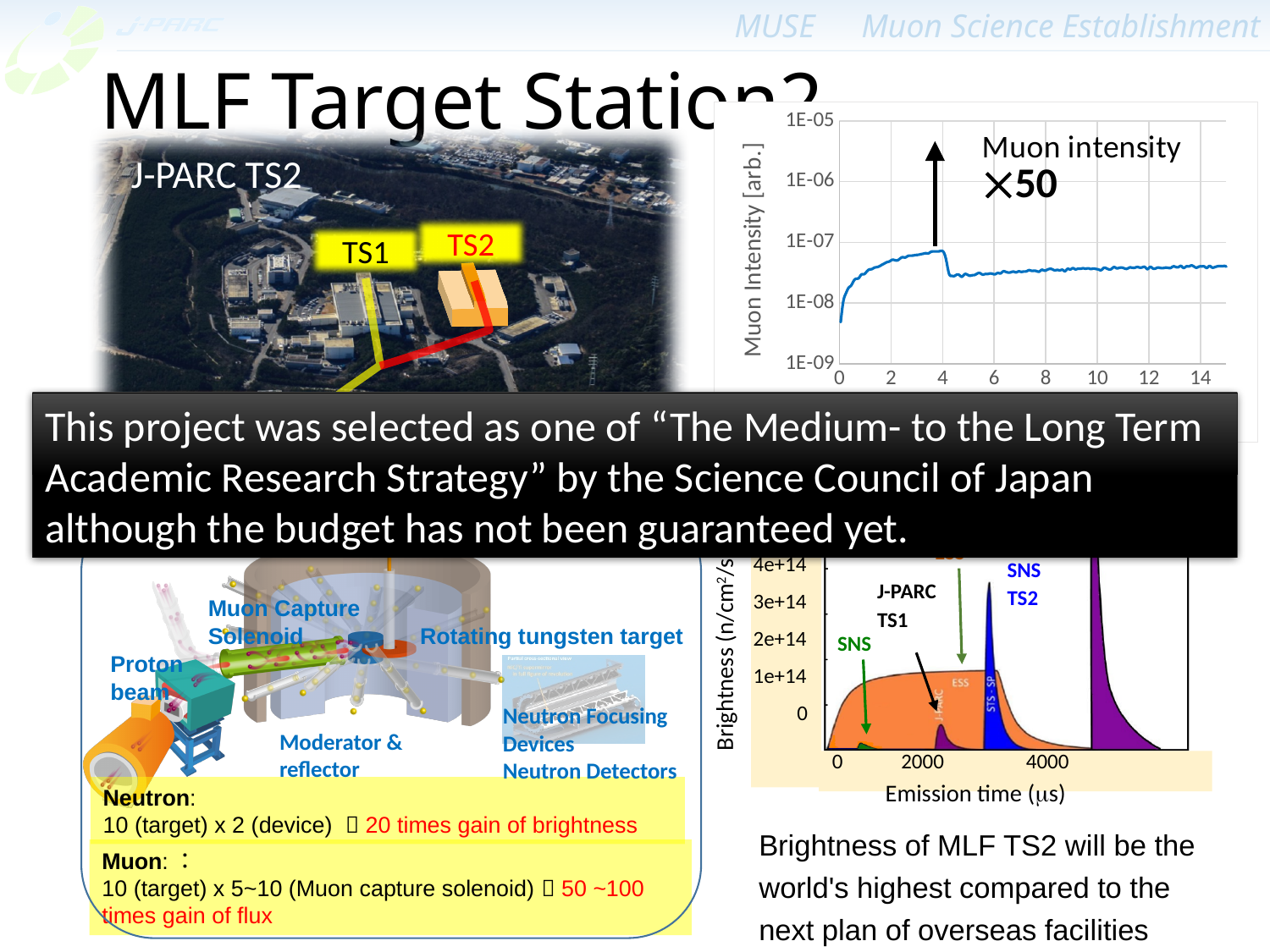
In the Brightness chart at the bottom right, is the peak brightness of J-PARC TS1 greater or less than 1e+14? less What kind of chart is the Muon Intensity chart at the top right of the slide? line chart In the Muon Intensity chart at the top right, is the value at x = 2 greater or less than 1E-08? greater In the Muon Intensity chart at the top right, is the value at x = 10 greater or less than 1E-07? less In the Muon Intensity chart at the top right, what is the label on the y-axis? Muon Intensity [arb.] In the Brightness chart at the bottom right, what is the highest tick value shown on the y-axis? 4e+14 In the Muon Intensity chart at the top right, what is the largest tick value on the x-axis? 14 In the Brightness chart at the bottom right, what is the label on the x-axis? Emission time (μs) In the Brightness chart at the bottom right, which has the higher peak brightness, J-PARC TS1 or SNS TS2? SNS TS2 In the Muon Intensity chart at the top right, what is the highest value shown on the y-axis? 1E-05 In the Muon Intensity chart at the top right, does the line rise or fall between x = 0 and x = 4? rise